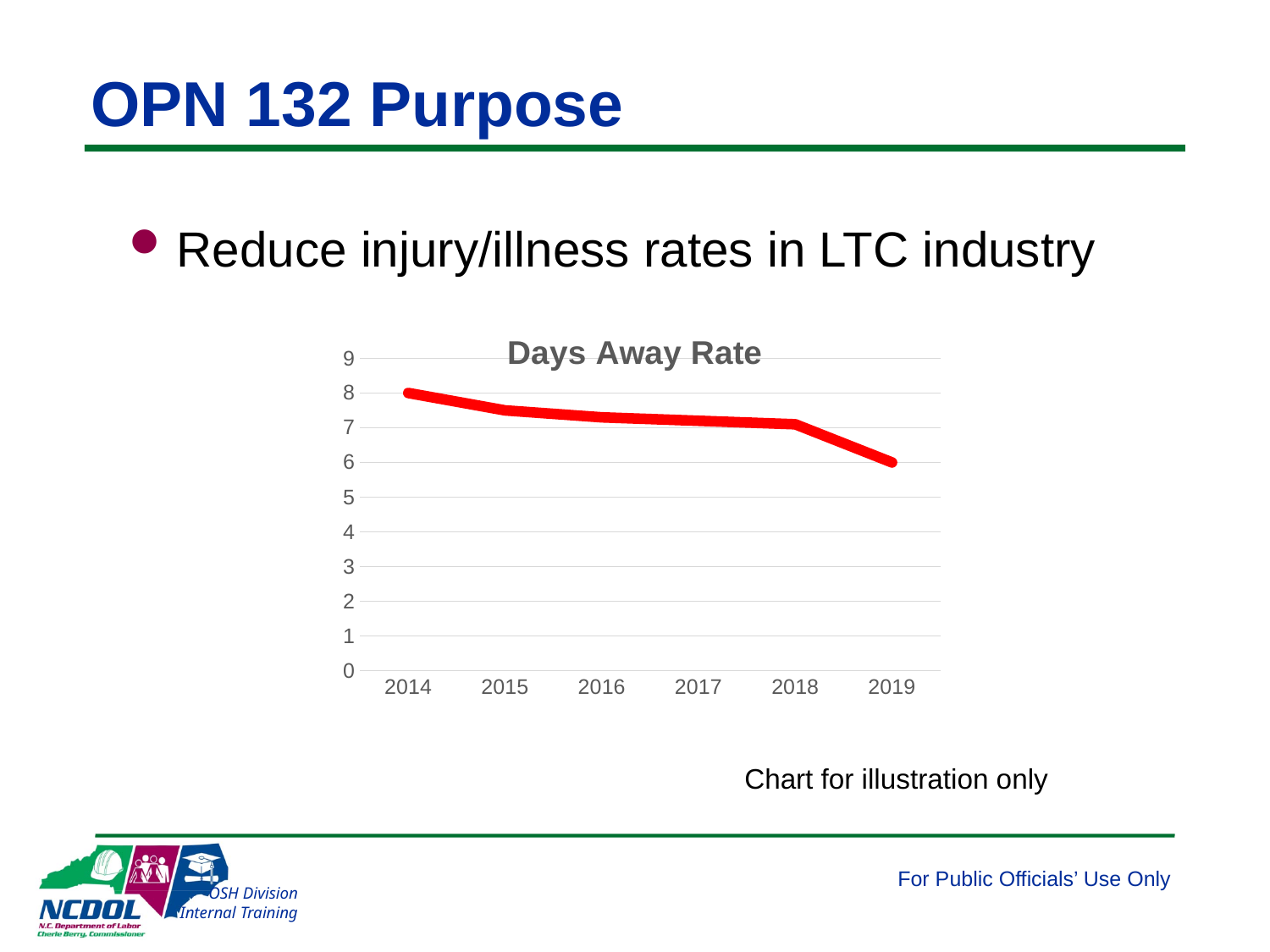
Is the Days Away Rate for 2017 greater or less than 8? less Which year has the highest Days Away Rate? 2014 Which year has the lowest Days Away Rate? 2019 What is the Days Away Rate for 2019? 6 How many years are plotted on the x axis of the chart? 6 What is the title of the chart? Days Away Rate Does the Days Away Rate rise or fall from 2014 to 2019? fall Is the Days Away Rate for 2015 greater or less than 7? greater Which year has the larger Days Away Rate, 2015 or 2019? 2015 What is the Days Away Rate for 2014? 8 Is the Days Away Rate for 2019 greater or less than 7? less What type of chart is shown on the slide? line chart